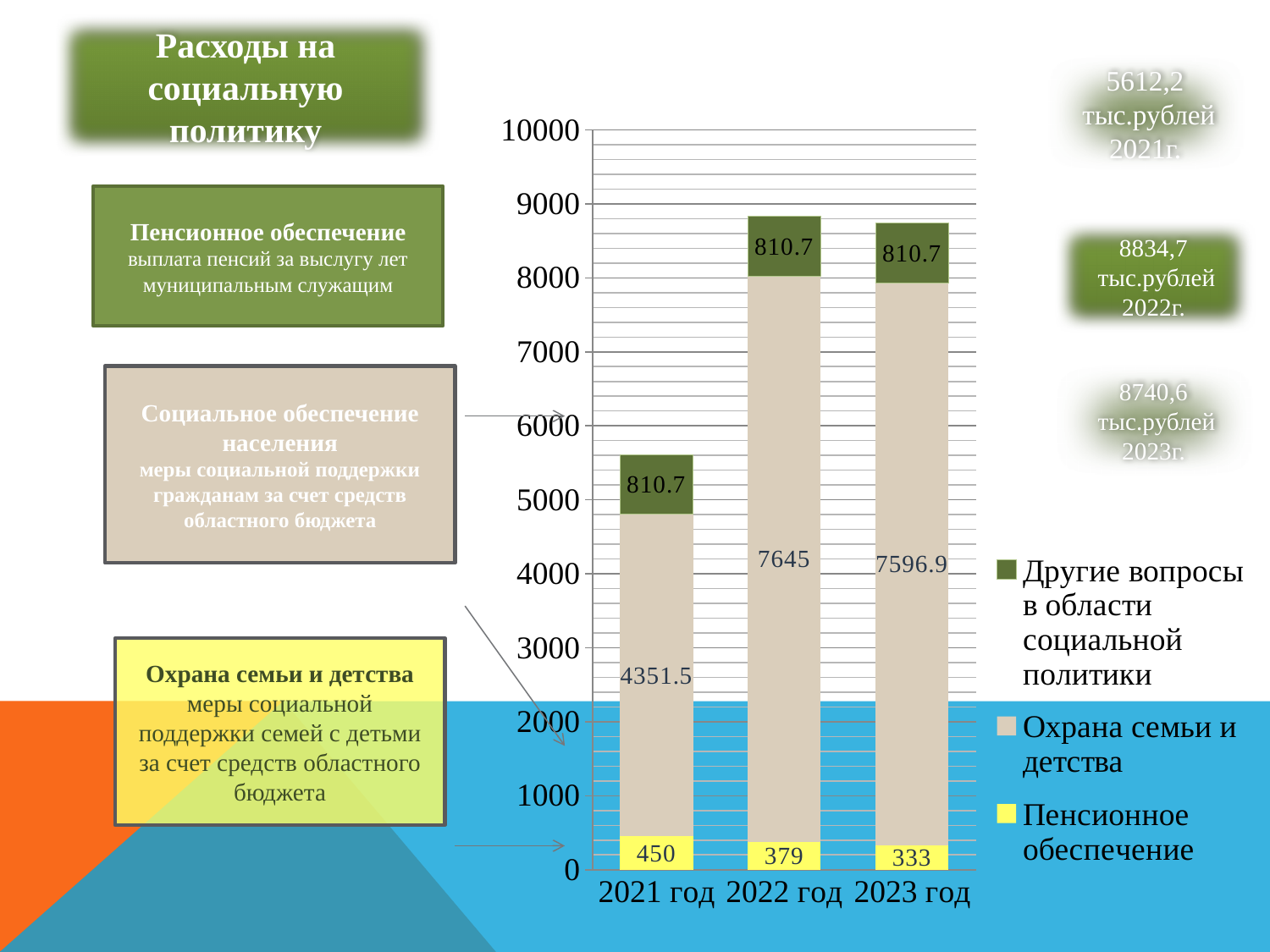
What is the value of Пенсионное обеспечение for 2021 год? 450 What is the total of the stacked bar for 2021 год? 5612.2 How many series does the legend list? 3 What is the value of Охрана семьи и детства for 2022 год? 7645 In which year is the value of Охрана семьи и детства the highest? 2022 год What type of chart is shown on the slide? stacked bar chart In which year is the value of Пенсионное обеспечение the lowest? 2023 год Which is larger: Пенсионное обеспечение for 2021 год or for 2022 год? 2021 год What is the value of Другие вопросы в области социальной политики for 2023 год? 810.7 How many years are shown on the x axis? 3 What is the difference between the Охрана семьи и детства values for 2022 год and 2021 год? 3293.5 Does the value of Пенсионное обеспечение rise or fall from 2021 год to 2023 год? fall